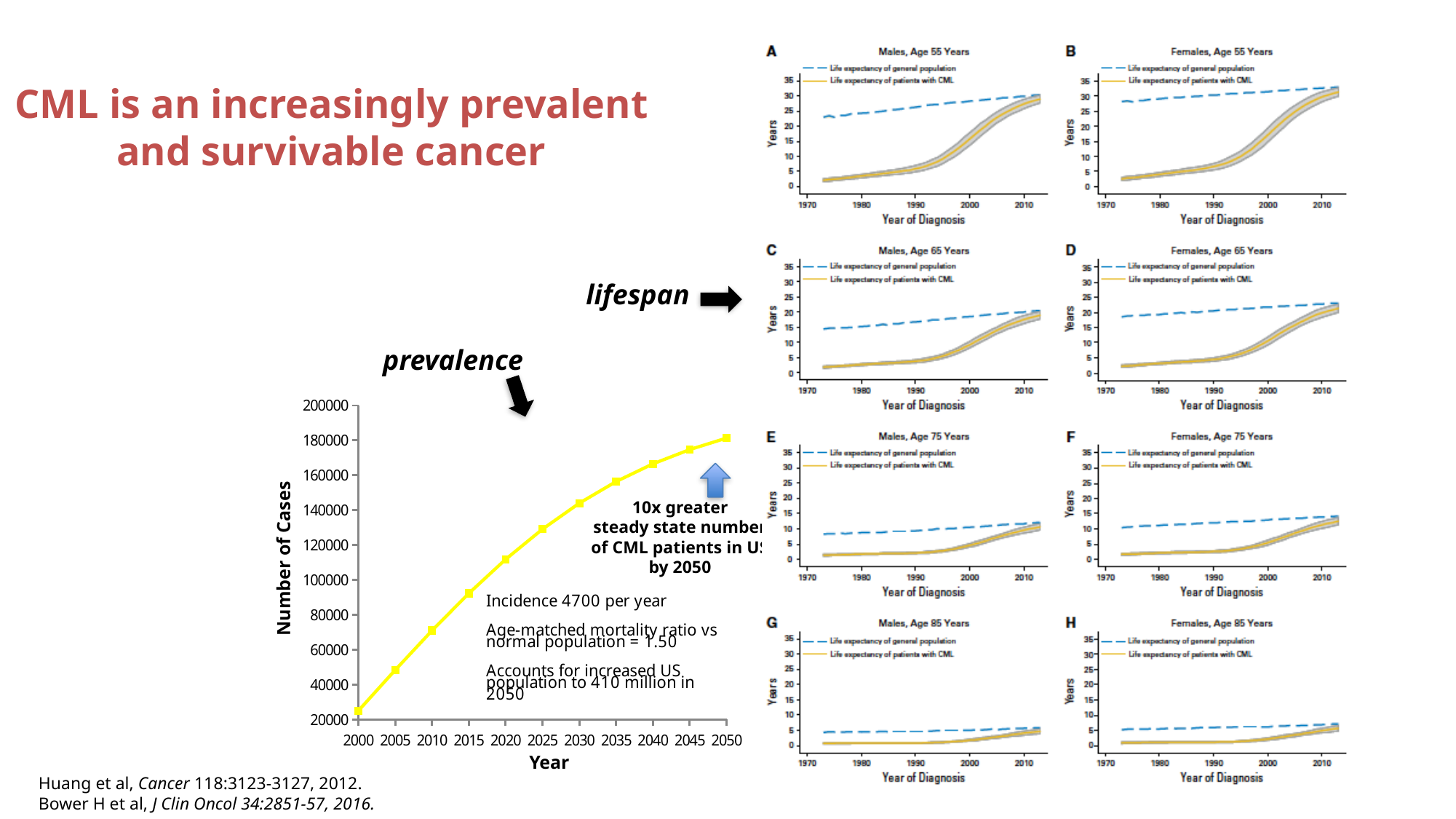
How many series does the legend list in panel A (Males, Age 55 Years) of the life expectancy charts? 2 On the prevalence chart (Number of Cases vs Year), is the value for 2020 greater or less than 100000? greater What kind of chart is the prevalence chart (Number of Cases vs Year) on the left of the slide? line chart How many life expectancy panels (A through H) are shown on the right side of the slide? 8 On the prevalence chart (Number of Cases vs Year), is the value for 2050 greater or less than 160000? greater In panel A (Males, Age 55 Years), which series is higher in 1980: life expectancy of general population or life expectancy of patients with CML? Life expectancy of general population How many data points are plotted on the prevalence chart (Number of Cases vs Year)? 11 What is the y-axis title of the prevalence chart on the left of the slide? Number of Cases On the prevalence chart (Number of Cases vs Year), is the value for 2000 greater or less than 40000? less On the prevalence chart (Number of Cases vs Year), do the values rise or fall from 2000 to 2050? rise In panel A (Males, Age 55 Years), does the life expectancy of patients with CML rise or fall from 1970 to 2010? rise